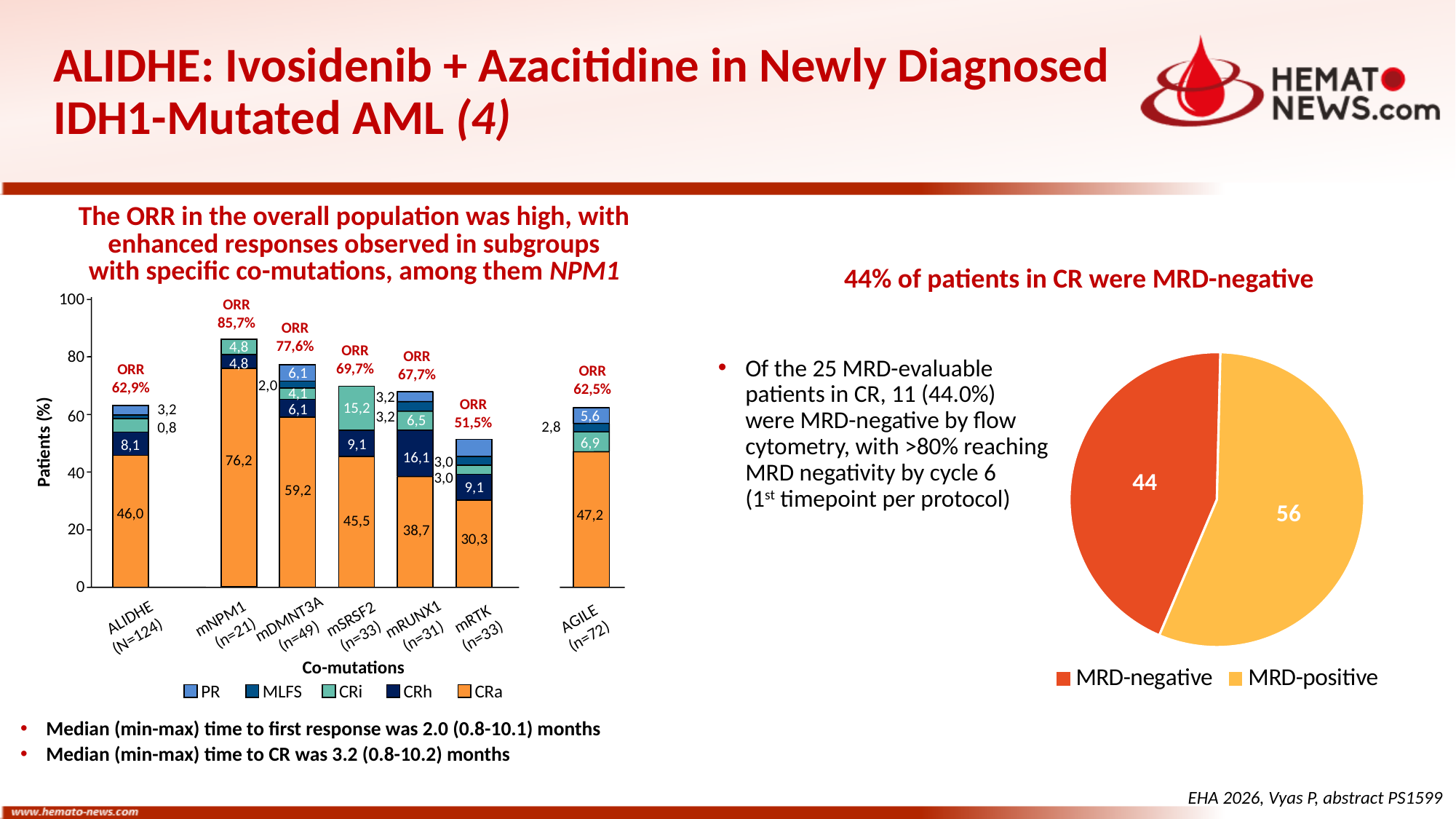
How many entries does the legend of the pie chart on the right list? 2 In the pie chart on the right, what percentage of patients in CR were MRD-negative? 44 In the bar chart on the left, what is the ORR for mDMNT3A (n=49)? 77,6% In the bar chart on the left, what is the CRa value for mNPM1 (n=21)? 76,2 In the bar chart on the left, which category has the lowest CRa value? mRTK (n=33) What kind of chart is shown on the left side of the slide? Stacked bar chart In the bar chart on the left, which subgroup has the highest ORR? mNPM1 (n=21) How many series does the legend of the bar chart on the left list? 5 What kind of chart is shown on the right side of the slide? Pie chart How many categories are shown on the x axis of the bar chart on the left? 7 In the bar chart on the left, what is the difference between the CRa value for AGILE (n=72) and the CRa value for ALIDHE (N=124)? 1,2 In the pie chart on the right, which slice is larger, MRD-negative or MRD-positive? MRD-positive